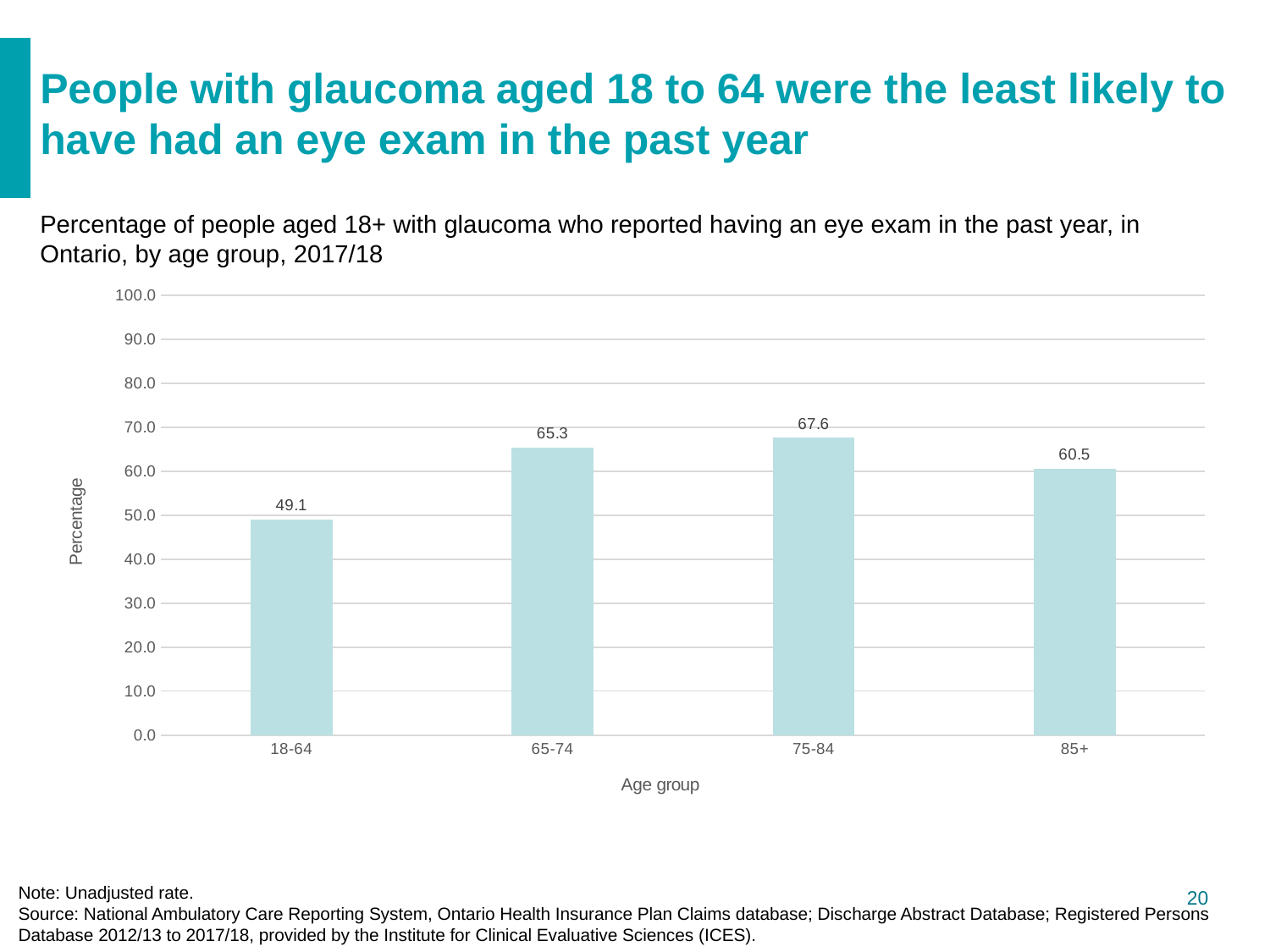
What is the label of the x axis? Age group Which age group has the lowest percentage? 18-64 What is the value for the 75-84 age group? 67.6 What kind of chart is shown on the slide? bar chart What is the value for the 65-74 age group? 65.3 How many age groups are shown on the chart? 4 Which is larger, the value for 65-74 or the value for 85+? 65-74 Is the value for the 18-64 age group greater or less than 50.0? less Which age group has the highest percentage? 75-84 What is the value for the 85+ age group? 60.5 What is the value for the 18-64 age group? 49.1 What is the difference between the values for the 75-84 and 18-64 age groups? 18.5